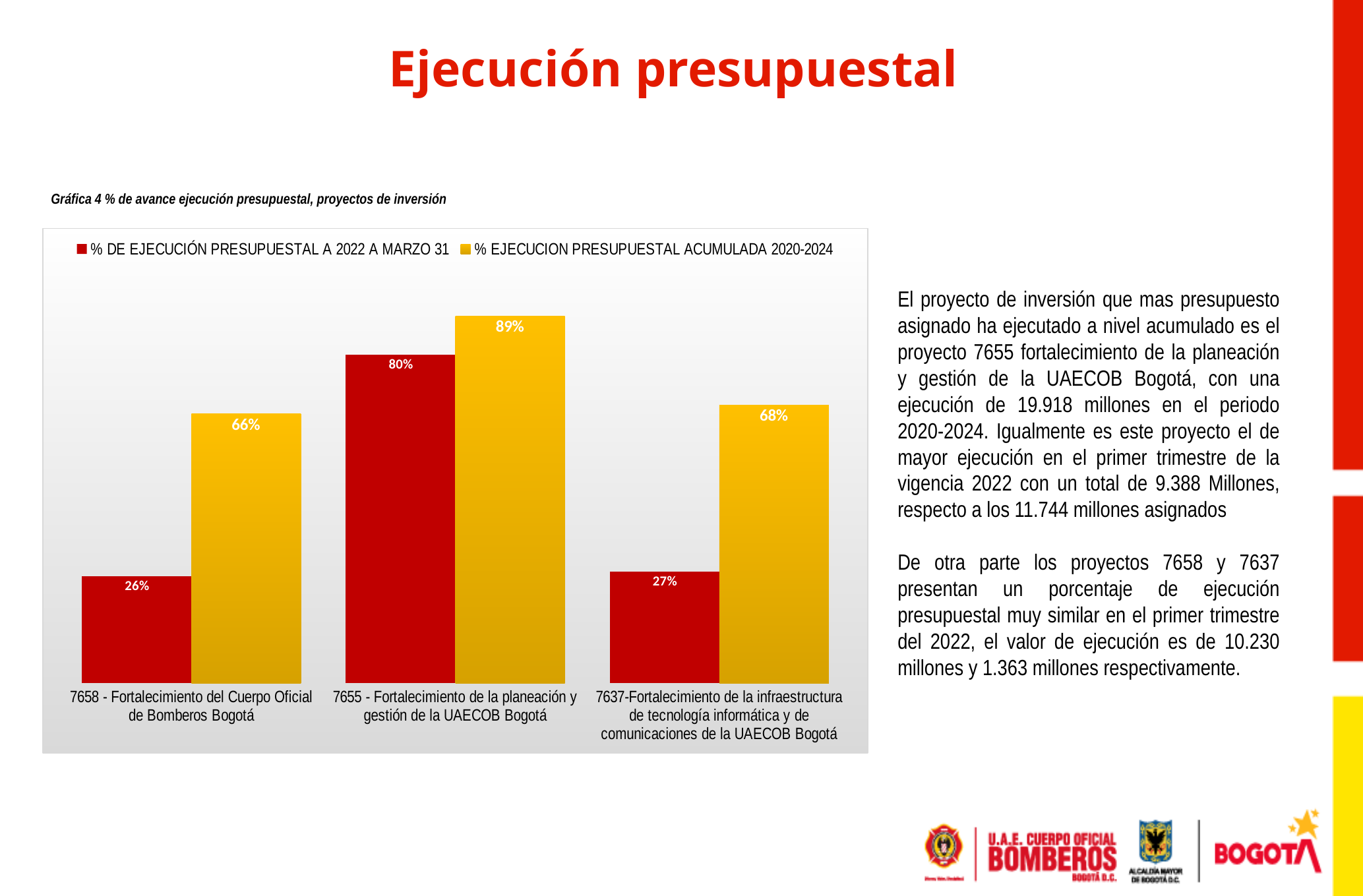
Which is larger: the % EJECUCION PRESUPUESTAL ACUMULADA 2020-2024 for project 7658 or for project 7637? 7637 Which colour represents the % EJECUCION PRESUPUESTAL ACUMULADA 2020-2024 series? Yellow How many projects (categories) are shown on the chart? 3 Which project has the lowest % DE EJECUCIÓN PRESUPUESTAL A 2022 A MARZO 31? 7658 - Fortalecimiento del Cuerpo Oficial de Bomberos Bogotá What kind of chart is shown on the slide? Bar chart Which project has the highest % EJECUCION PRESUPUESTAL ACUMULADA 2020-2024? 7655 - Fortalecimiento de la planeación y gestión de la UAECOB Bogotá What is the % DE EJECUCIÓN PRESUPUESTAL A 2022 A MARZO 31 value for project 7655 - Fortalecimiento de la planeación y gestión de la UAECOB Bogotá? 80% What is the difference between the % EJECUCION PRESUPUESTAL ACUMULADA 2020-2024 values of project 7655 and project 7637? 21% What is the % EJECUCION PRESUPUESTAL ACUMULADA 2020-2024 value for project 7658 - Fortalecimiento del Cuerpo Oficial de Bomberos Bogotá? 66% How many series does the chart legend list? 2 What is the % EJECUCION PRESUPUESTAL ACUMULADA 2020-2024 value for project 7637-Fortalecimiento de la infraestructura de tecnología informática y de comunicaciones de la UAECOB Bogotá? 68% What is the difference between the % EJECUCION PRESUPUESTAL ACUMULADA 2020-2024 and the % DE EJECUCIÓN PRESUPUESTAL A 2022 A MARZO 31 for project 7658? 40%